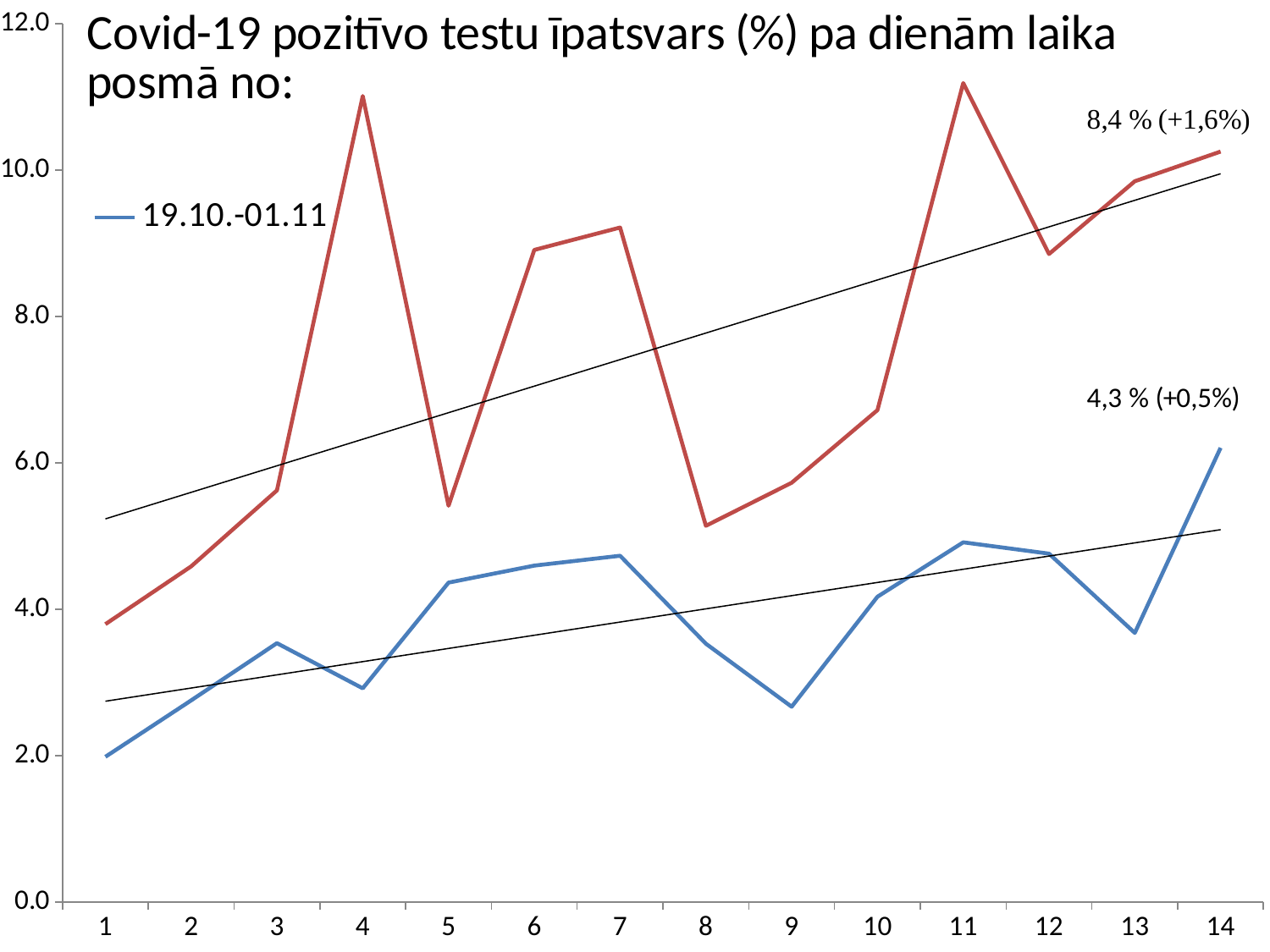
Is the value of the red line on day 4 greater or less than 10.0? greater On day 7, which line has the larger value, the red line or the blue line? red line How many days (points) are shown along the x axis? 14 On which day does the blue line reach its highest value? 14 On which day does the blue line have its lowest value? 1 Is the value of the red line on day 8 greater or less than 6.0? less On which day does the red line have its lowest value? 1 What is the legend entry for the blue line? 19.10.-01.11 What annotation is printed near the top of the red line on the right side of the chart? 8,4 % (+1,6%) How many series does the legend list? 1 What kind of chart is shown on the slide? line chart Is the value of the blue line on day 1 greater or less than 4.0? less